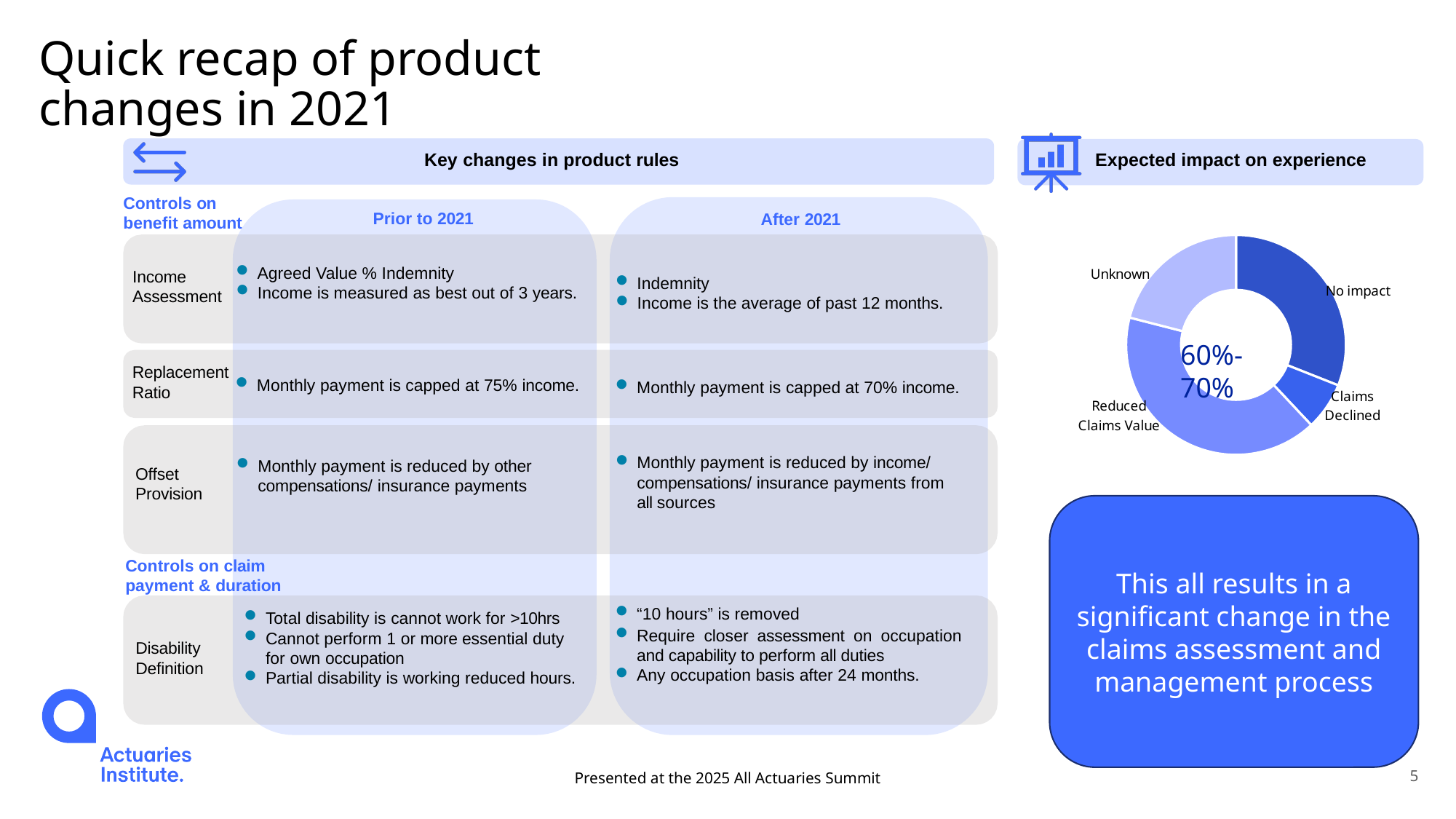
In the donut chart, which slice is larger: Unknown or Claims Declined? Unknown What kind of chart is shown under "Expected impact on experience"? donut (pie) chart In the donut chart, which slice is larger: No impact or Unknown? No impact What is the heading above the donut chart? Expected impact on experience Which category has the smallest slice in the donut chart? Claims Declined What text is printed in the centre of the donut chart? 60%-70% In the donut chart, which slice is larger: No impact or Claims Declined? No impact How many categories does the donut chart show? 4